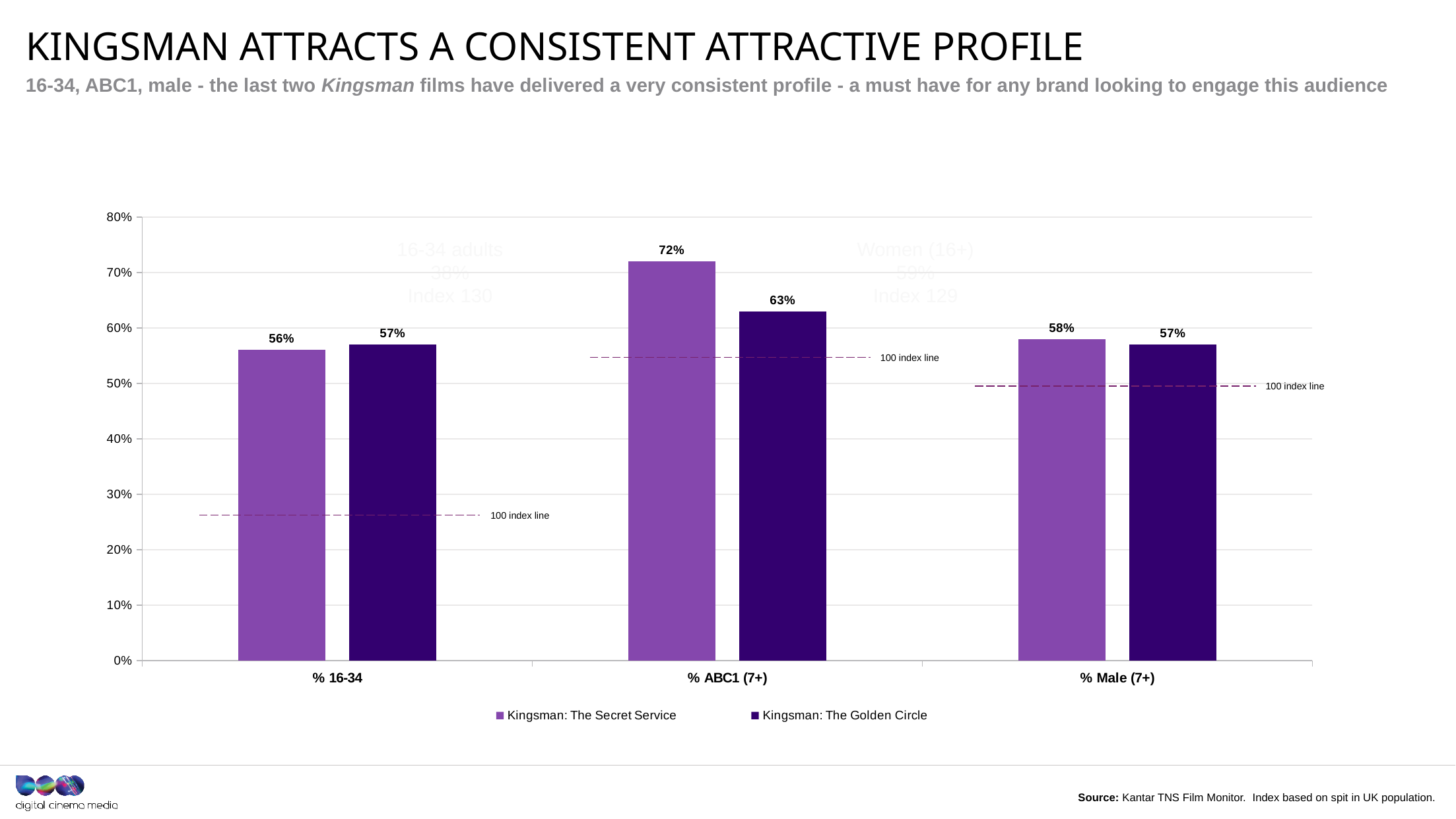
Which category has the lowest value for Kingsman: The Golden Circle? % 16-34 and % Male (7+) (tied at 57%) What is the value for Kingsman: The Secret Service in the % Male (7+) category? 58% In the % ABC1 (7+) category, which film has the larger value? Kingsman: The Secret Service What is the value for Kingsman: The Golden Circle in the % ABC1 (7+) category? 63% Which category has the highest value for Kingsman: The Secret Service? % ABC1 (7+) What is the difference between Kingsman: The Secret Service and Kingsman: The Golden Circle in the % ABC1 (7+) category? 9% What is the value for Kingsman: The Secret Service in the % 16-34 category? 56% What kind of chart is shown on the slide? Bar chart What is the value for Kingsman: The Golden Circle in the % 16-34 category? 57% What is the label of the dashed horizontal lines drawn across each category? 100 index line How many categories are shown on the x axis? 3 How many series does the legend list? 2